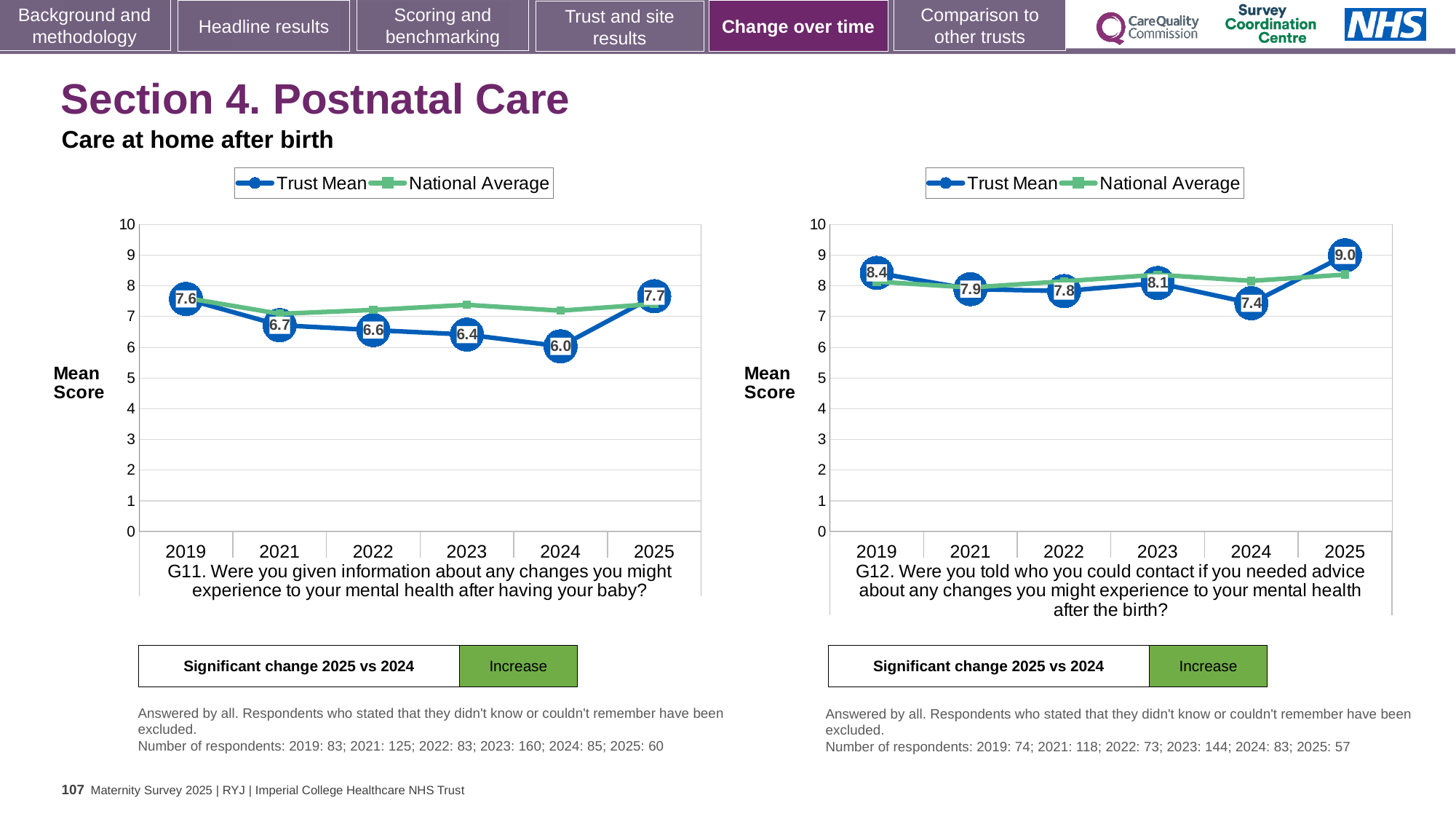
In the G12 chart (right), which year has the highest Trust Mean score? 2025 In the G12 chart (right), what is the Trust Mean score for 2025? 9.0 In the G11 chart (left), does the Trust Mean rise or fall from 2019 to 2024? fall What type of chart is the G11 chart (left)? line chart In the G12 chart (right), is the Trust Mean score for 2019 higher or lower than for 2024? higher In the G11 chart (left), what is the Trust Mean score for 2024? 6.0 In the G12 chart (right), what is the difference between the Trust Mean scores for 2025 and 2024? 1.6 In the G11 chart (left), is the National Average for 2024 greater or less than 6? greater How many years are plotted on the x axis of the G11 chart (left)? 6 In the G11 chart (left), which year has the lowest Trust Mean score? 2024 In the G11 chart (left), what is the difference between the Trust Mean scores for 2025 and 2024? 1.7 How many series does the legend of the G12 chart (right) list? 2